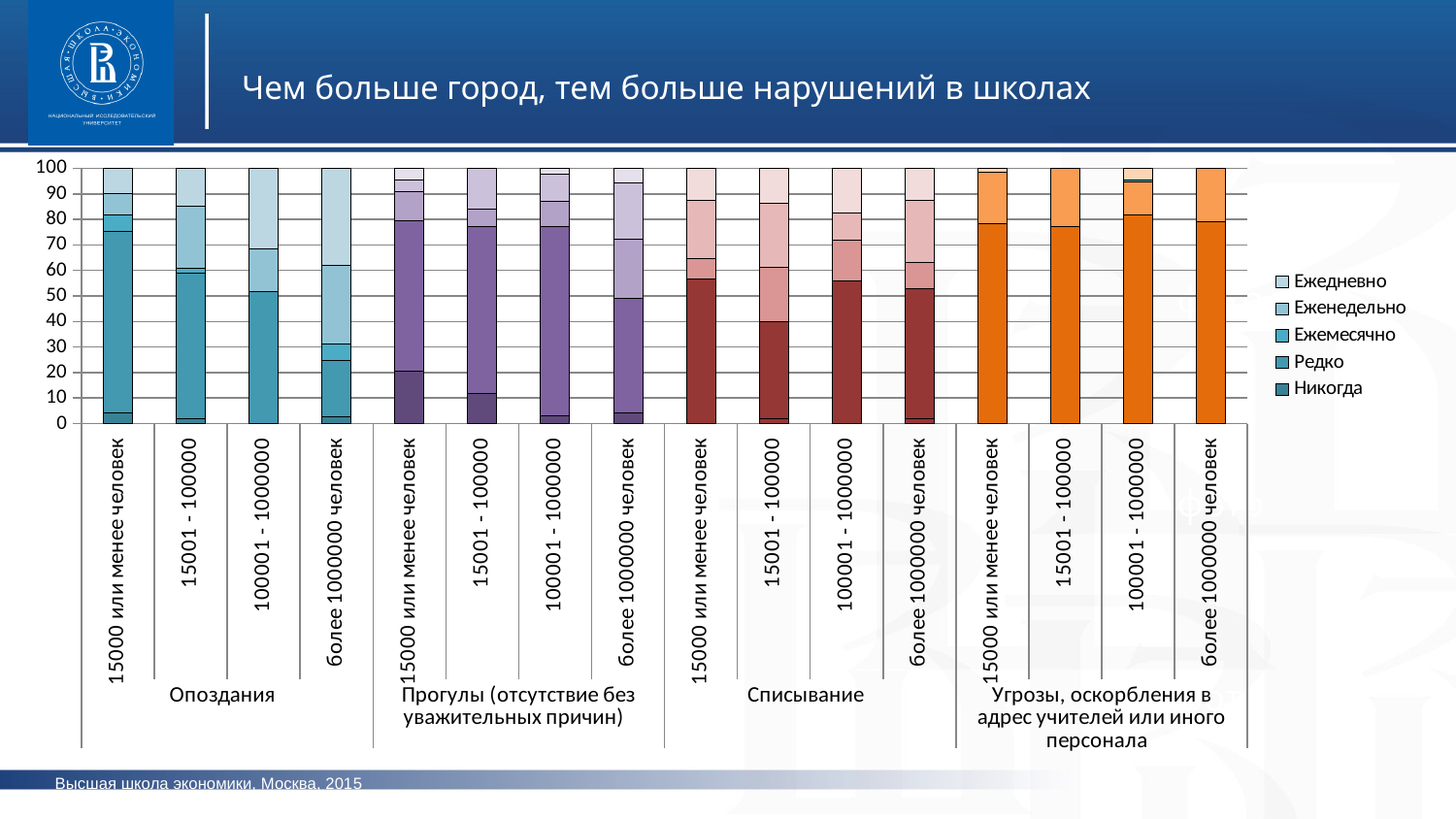
In the Списывание group, is the top of the Редко segment for '15001 - 100000' greater or less than 50? less What is the title of the slide above the chart? Чем больше город, тем больше нарушений в школах What kind of chart is shown on the slide? stacked bar chart In the Прогулы group, is the top of the Никогда segment for '15000 или менее человек' greater or less than 30? less In the Прогулы group, which has the larger Никогда segment: '15000 или менее человек' or '15001 - 100000'? 15000 или менее человек How many series does the legend list? 5 How many bars are plotted in the chart? 16 In the Опоздания group, which city size has the smallest Редко segment? более 1000000 человек Which series are listed in the legend? Ежедневно, Еженедельно, Ежемесячно, Редко, Никогда How many violation categories (groups) are shown along the x axis? 4 In the Угрозы, оскорбления group, is the top of the Редко segment for '15001 - 100000' greater or less than 60? greater In the Опоздания group, which has the larger Редко segment: '15000 или менее человек' or 'более 1000000 человек'? 15000 или менее человек